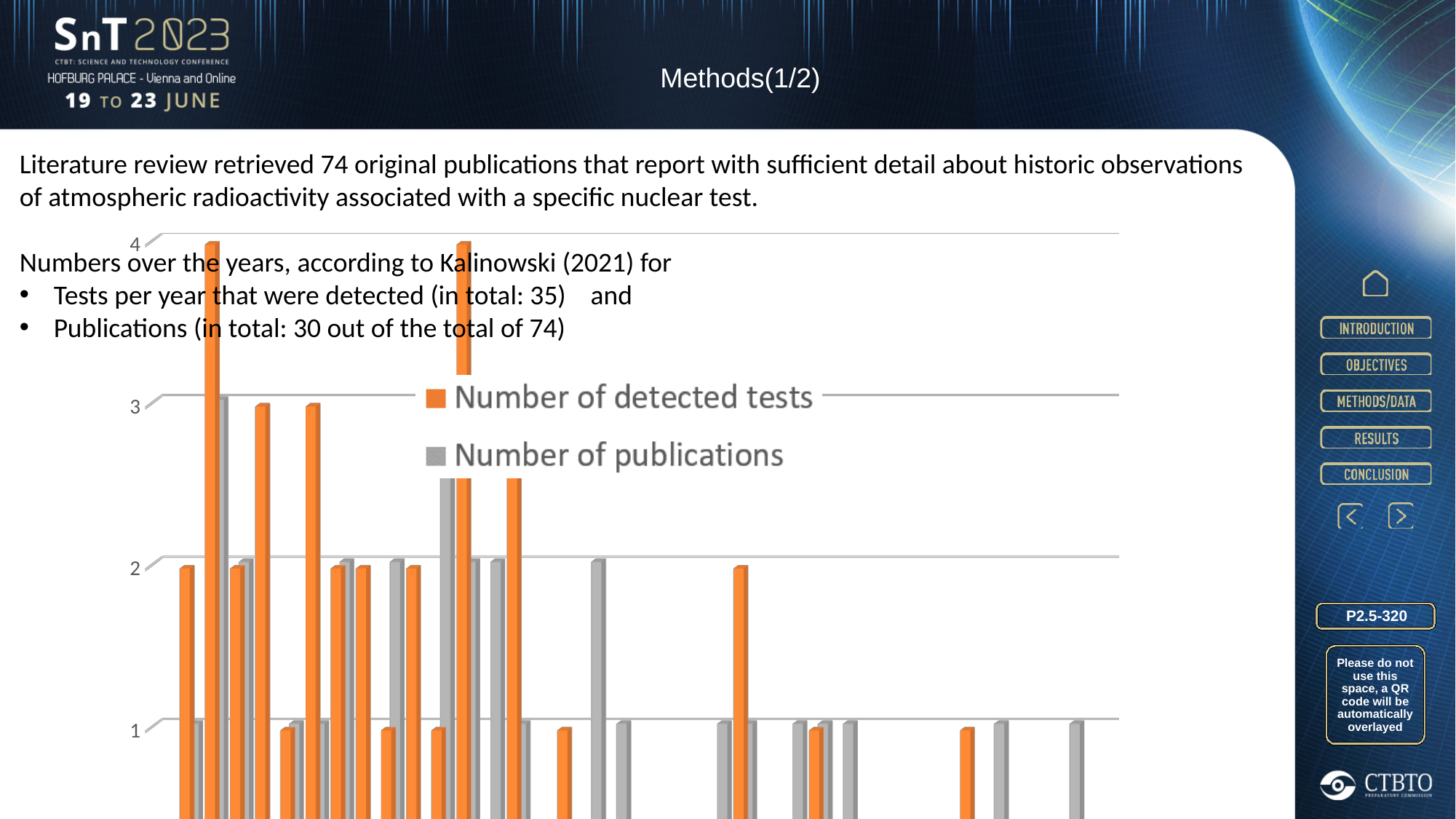
What is the highest value reached by any bar in the 'Number of publications' series? 3 Is the tallest bar in the 'Number of publications' series greater or less than 4? less Which colour represents the 'Number of detected tests' series in the chart? orange What is the highest tick value labelled on the chart's vertical axis? 4 How many labelled tick values are shown on the chart's vertical axis? 4 What are the two series named in the chart legend? Number of detected tests; Number of publications Which series reaches a higher maximum value, 'Number of detected tests' or 'Number of publications'? Number of detected tests What kind of chart is shown on the slide? bar chart How many series does the chart legend list? 2 What is the highest value reached by any bar in the 'Number of detected tests' series? 4